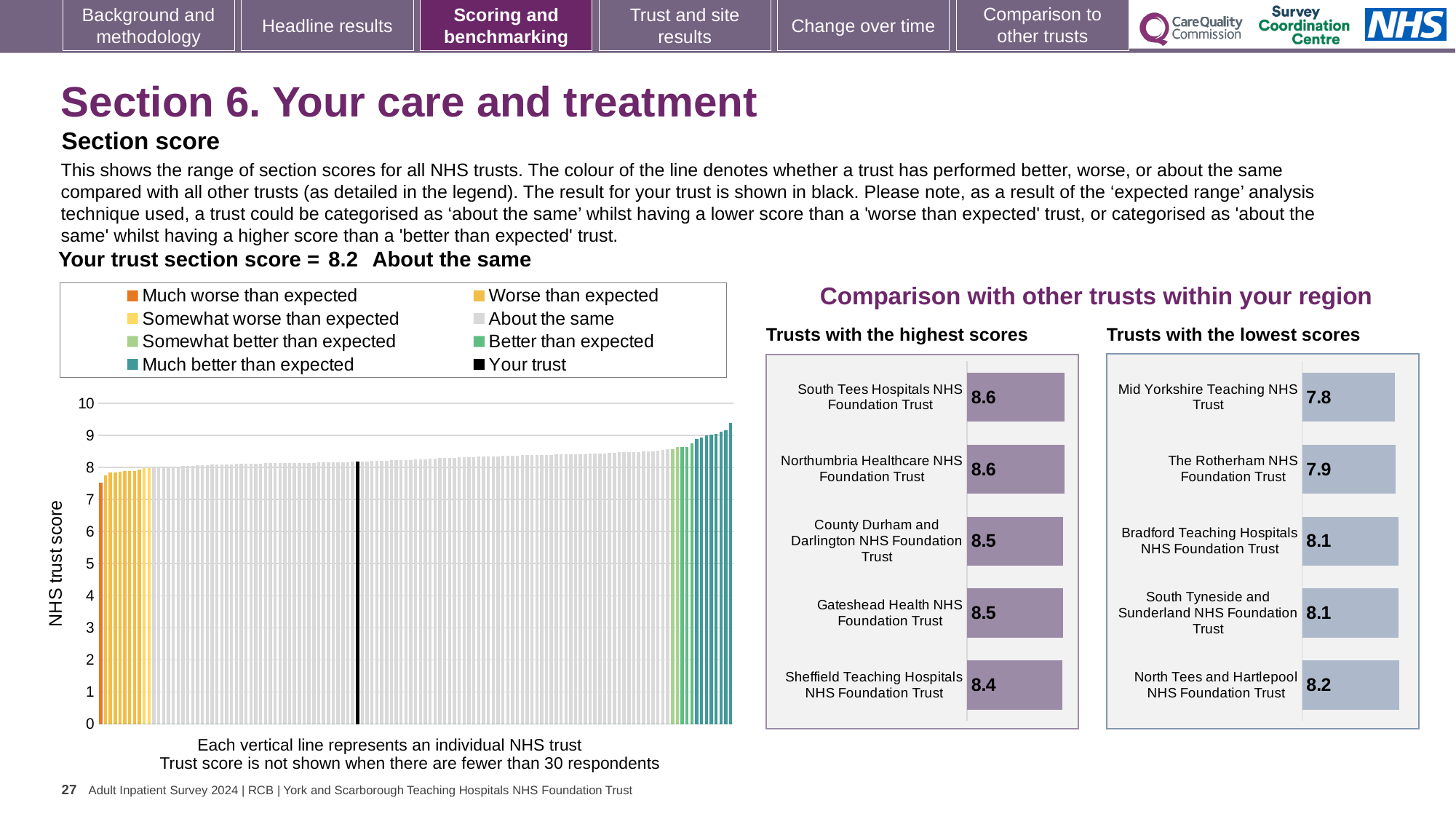
In the main 'NHS trust score' chart, do the bar heights rise or fall from left to right? rise In the 'Trusts with the highest scores' chart, what is the score for County Durham and Darlington NHS Foundation Trust? 8.5 How many trusts are shown in the 'Trusts with the highest scores' chart? 5 In the 'Trusts with the lowest scores' chart, what is the difference between the scores of North Tees and Hartlepool NHS Foundation Trust and Mid Yorkshire Teaching NHS Trust? 0.4 In the 'Trusts with the lowest scores' chart, what is the score for Mid Yorkshire Teaching NHS Trust? 7.8 In the 'Trusts with the lowest scores' chart, which trust has the highest score? North Tees and Hartlepool NHS Foundation Trust In the 'Trusts with the lowest scores' chart, which has the higher score: The Rotherham NHS Foundation Trust or Bradford Teaching Hospitals NHS Foundation Trust? Bradford Teaching Hospitals NHS Foundation Trust In the 'Trusts with the lowest scores' chart, which trust has the lowest score? Mid Yorkshire Teaching NHS Trust In the 'Trusts with the highest scores' chart, what is the score for Sheffield Teaching Hospitals NHS Foundation Trust? 8.4 In the 'Trusts with the highest scores' chart, which trust has the lowest score? Sheffield Teaching Hospitals NHS Foundation Trust How many entries does the legend of the main 'NHS trust score' chart list? 8 In the 'Trusts with the highest scores' chart, what is the difference between the scores of South Tees Hospitals NHS Foundation Trust and Sheffield Teaching Hospitals NHS Foundation Trust? 0.2